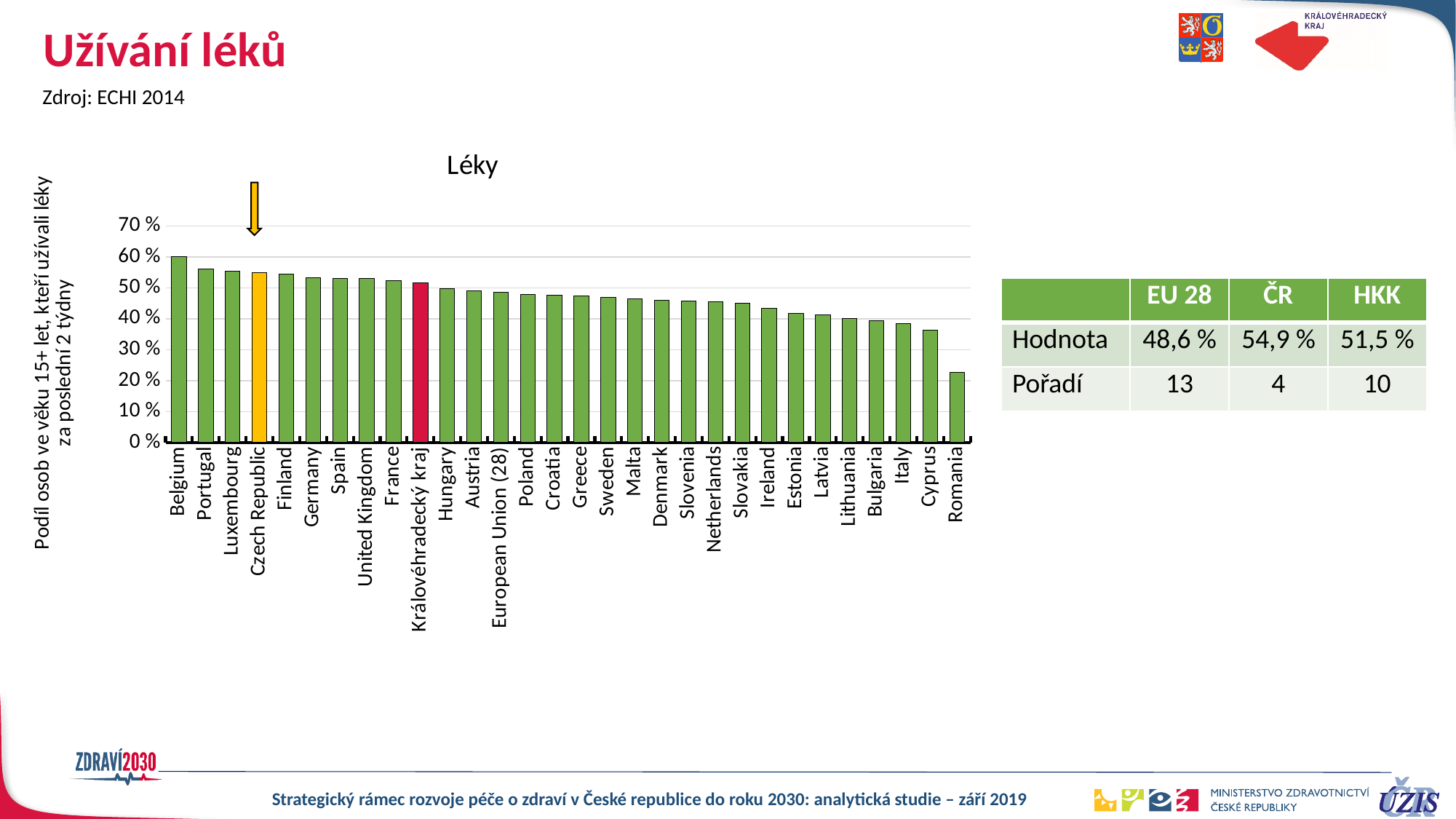
What is the value for the Czech Republic (ČR) according to the table on the slide? 54,9 % Which country has the lowest value in the chart? Romania Which country has the highest value in the chart? Belgium Is the value for Cyprus greater or less than 40 %? less Is the value for Belgium greater or less than 50 %? greater How many bars (categories) are plotted in the chart? 30 Which has the larger value, Portugal or Italy? Portugal What is the value for Královéhradecký kraj (HKK) according to the table on the slide? 51,5 % Do the values rise or fall from left to right along the x axis? fall What kind of chart is shown on the slide? bar chart What is the title of the chart? Léky Is the value for Romania greater or less than 30 %? less